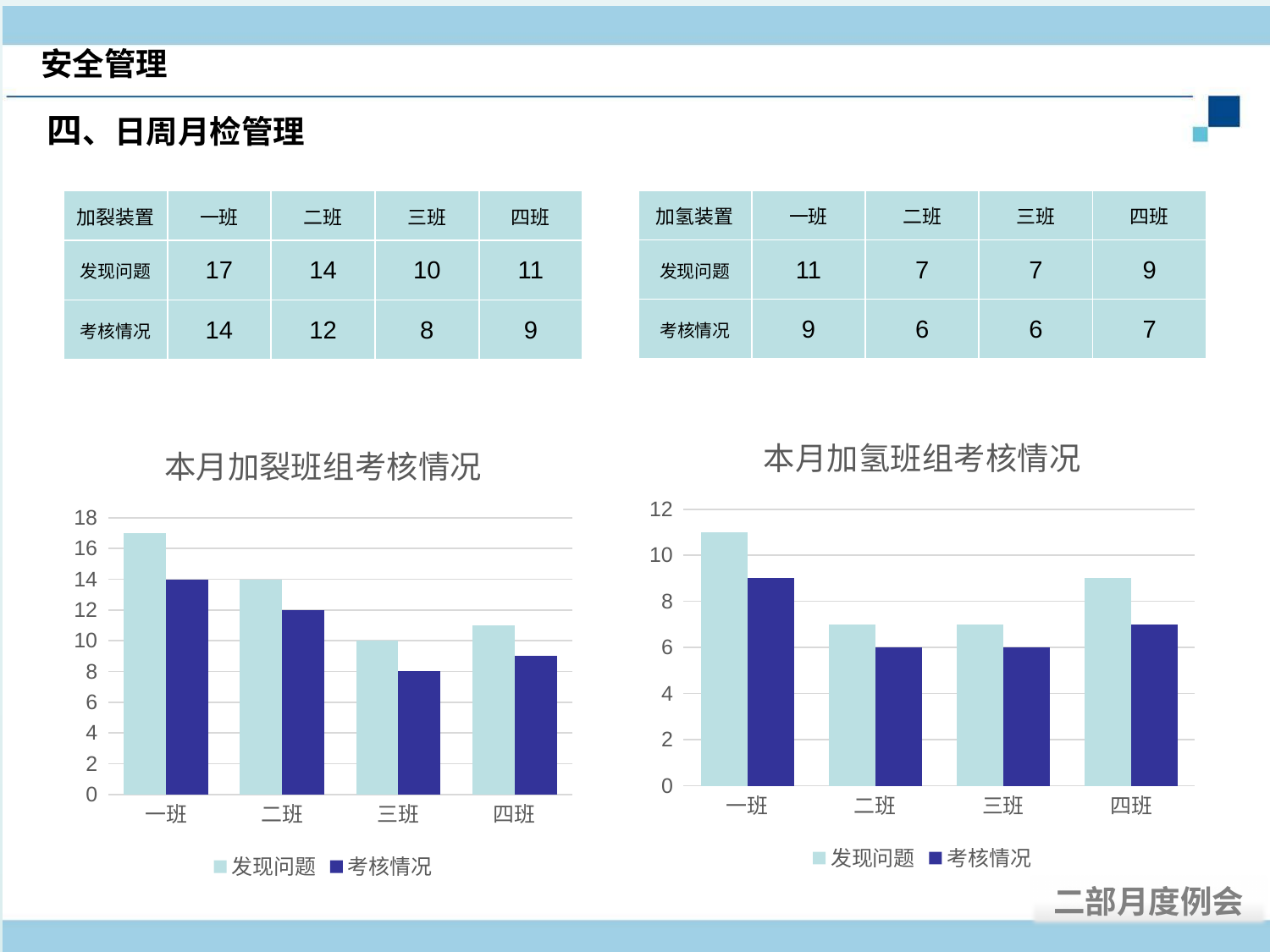
In the chart titled 本月加氢班组考核情况, which category has the highest 考核情况 value? 一班 In the chart titled 本月加氢班组考核情况, is the 发现问题 value for 一班 larger or smaller than the 发现问题 value for 四班? larger In the chart titled 本月加裂班组考核情况, what is the value of 考核情况 for 三班? 8 In the chart titled 本月加氢班组考核情况, what is the value of 考核情况 for 一班? 9 In the chart titled 本月加裂班组考核情况, what is the difference between 发现问题 and 考核情况 for 二班? 2 What kind of chart is the chart titled 本月加氢班组考核情况? bar chart In the chart titled 本月加裂班组考核情况, which category has the highest 发现问题 value? 一班 In the chart titled 本月加裂班组考核情况, what is the value of 发现问题 for 一班? 17 In the chart titled 本月加裂班组考核情况, which category has the lowest 考核情况 value? 三班 In the chart titled 本月加氢班组考核情况, how many categories are shown on the x axis? 4 In the chart titled 本月加裂班组考核情况, how many series does the legend list? 2 In the chart titled 本月加氢班组考核情况, what is the value of 发现问题 for 四班? 9